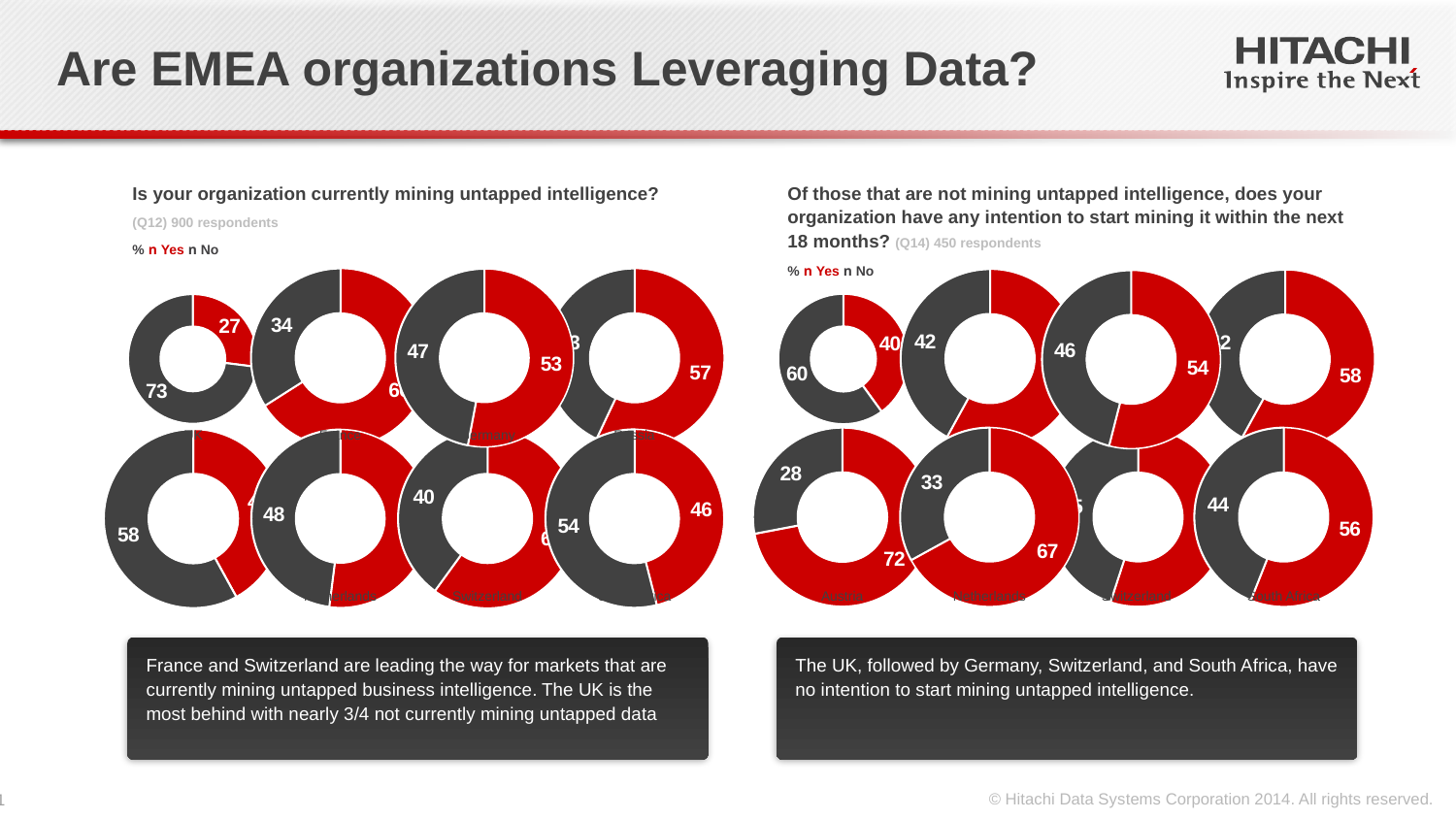
How many respondents answered Q12 ("Is your organization currently mining untapped intelligence?")? 900 respondents In the right chart ("Of those that are not mining untapped intelligence..."), what is the No value in the top-left donut? 60 Which colour represents "Yes" in the donut charts on this slide? Red How many series does the legend of the left chart ("Is your organization currently mining untapped intelligence?") list? 2 In the left chart ("Is your organization currently mining untapped intelligence?"), what is the Yes value in the bottom-right donut? 46 In the right chart ("Of those that are not mining untapped intelligence..."), what is the Yes value in the bottom-left donut? 72 In the left chart ("Is your organization currently mining untapped intelligence?"), what is the Yes value in the top-left donut? 27 In the left chart ("Is your organization currently mining untapped intelligence?"), what is the No value in the top-left donut? 73 In the right chart ("Of those that are not mining untapped intelligence..."), which is larger in the bottom-left donut, Yes or No? Yes How many donut charts are shown under the left question ("Is your organization currently mining untapped intelligence?")? 8 What kind of charts are used on this slide to show the survey results? Donut (pie) charts In the left chart ("Is your organization currently mining untapped intelligence?"), what is the difference between the No and Yes values in the top-left donut? 46